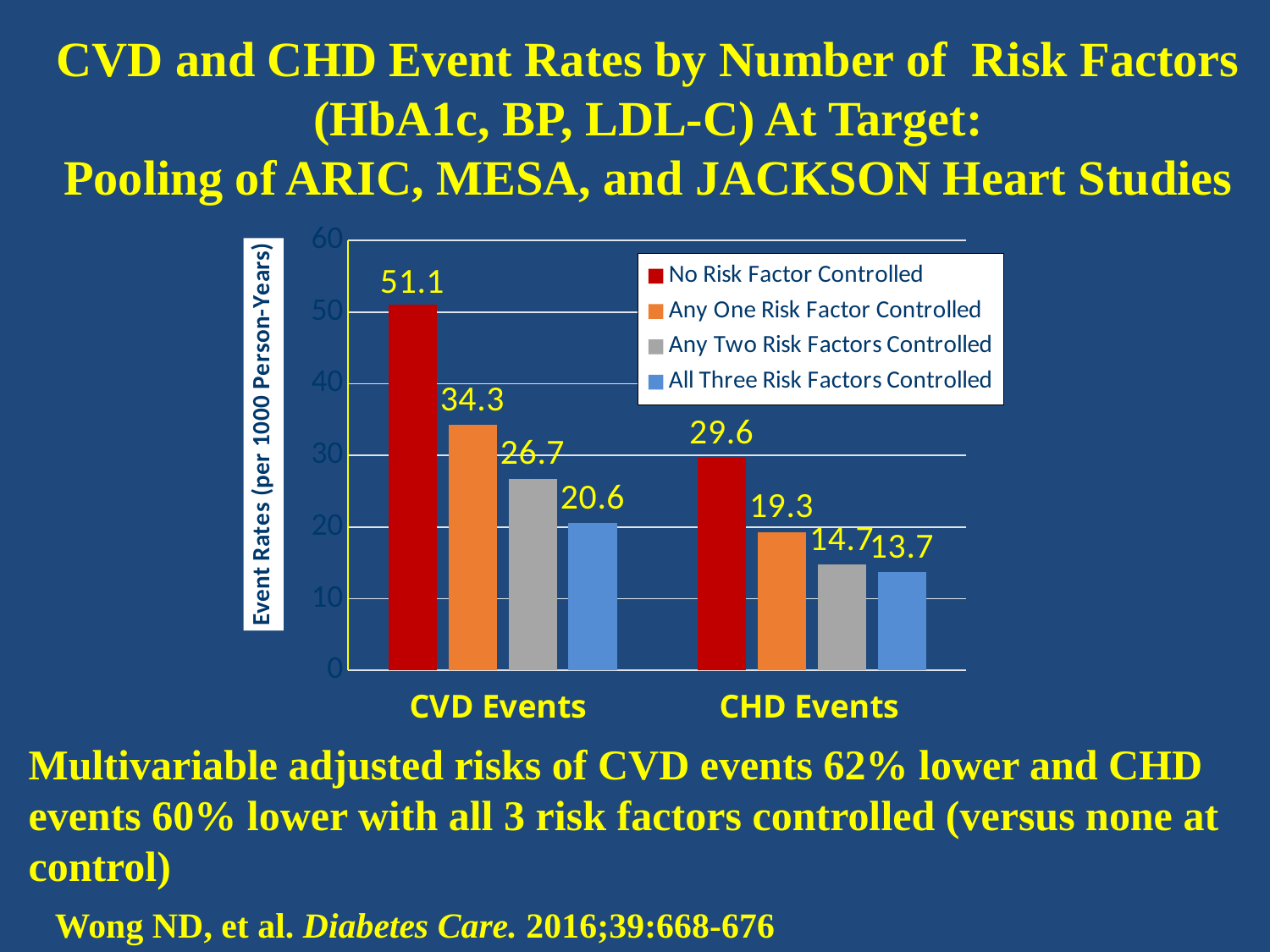
What is the CVD event rate for the No Risk Factor Controlled group? 51.1 How many series does the legend list? 4 How many categories are shown on the x axis? 2 What is the label of the y axis? Event Rates (per 1000 Person-Years) What is the CVD event rate for the Any Two Risk Factors Controlled group? 26.7 What type of chart is shown on the slide? Bar chart What is the CHD event rate for the Any One Risk Factor Controlled group? 19.3 Which series has the lowest CHD event rate? All Three Risk Factors Controlled What is the difference between the CVD event rates for No Risk Factor Controlled and All Three Risk Factors Controlled? 30.5 Which series has the highest CVD event rate? No Risk Factor Controlled What is the CHD event rate for the All Three Risk Factors Controlled group? 13.7 Which is larger: the CVD event rate for Any One Risk Factor Controlled or the CHD event rate for No Risk Factor Controlled? CVD event rate for Any One Risk Factor Controlled